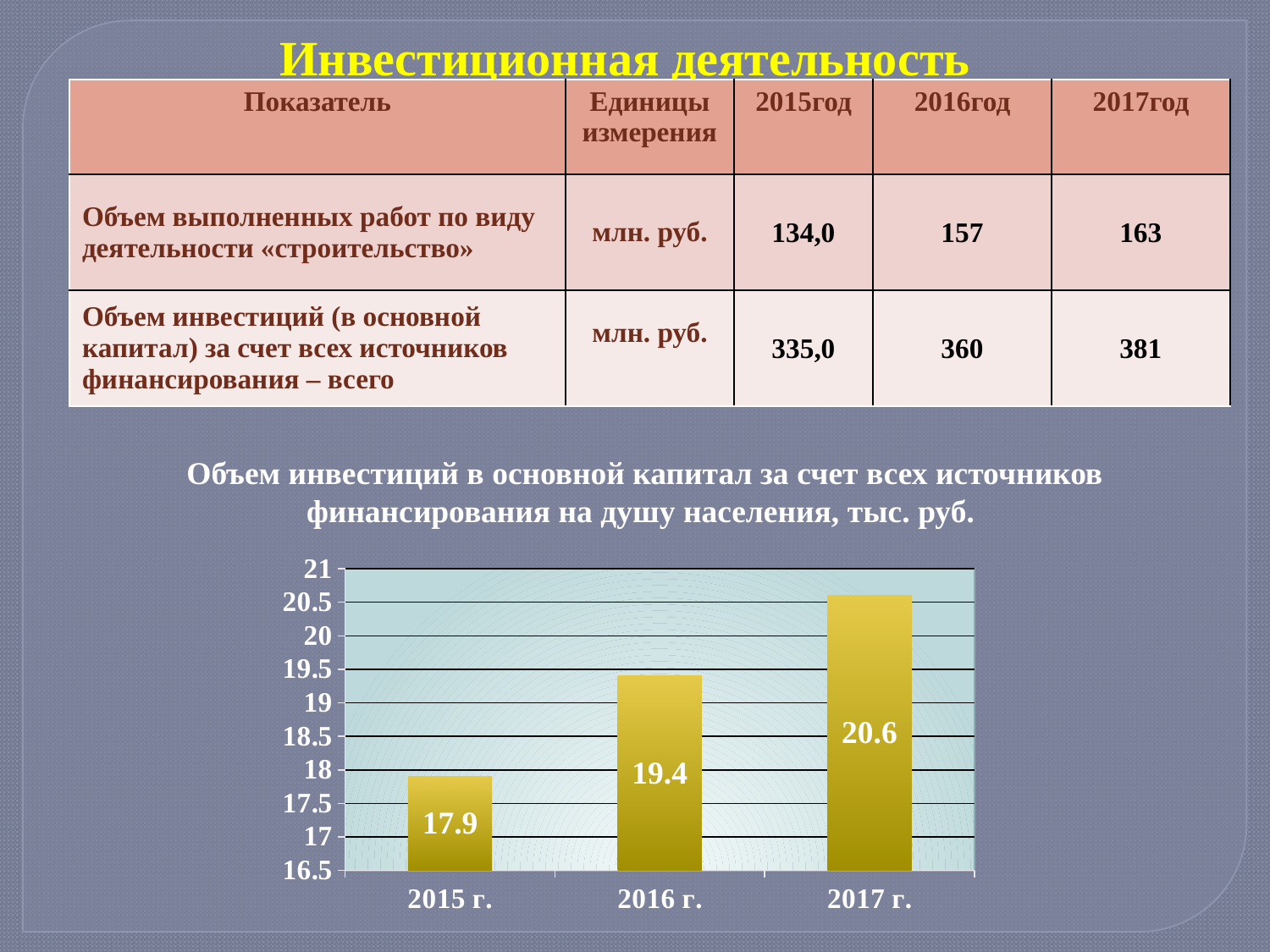
What is the value for 2017 г. in the bar chart? 20.6 Which is larger in the bar chart, the value for 2016 г. or the value for 2017 г.? 2017 г. Is the value for 2016 г. in the bar chart greater or less than 19? greater What type of chart is shown on the slide? bar chart Which year has the highest value in the bar chart? 2017 г. Which year has the lowest value in the bar chart? 2015 г. What is the difference between the values for 2016 г. and 2015 г. in the bar chart? 1.5 How many bars are shown in the bar chart? 3 What is the value for 2016 г. in the bar chart? 19.4 Do the values in the bar chart rise or fall from 2015 г. to 2017 г.? rise What is the value for 2015 г. in the bar chart? 17.9 What is the difference between the values for 2017 г. and 2015 г. in the bar chart? 2.7